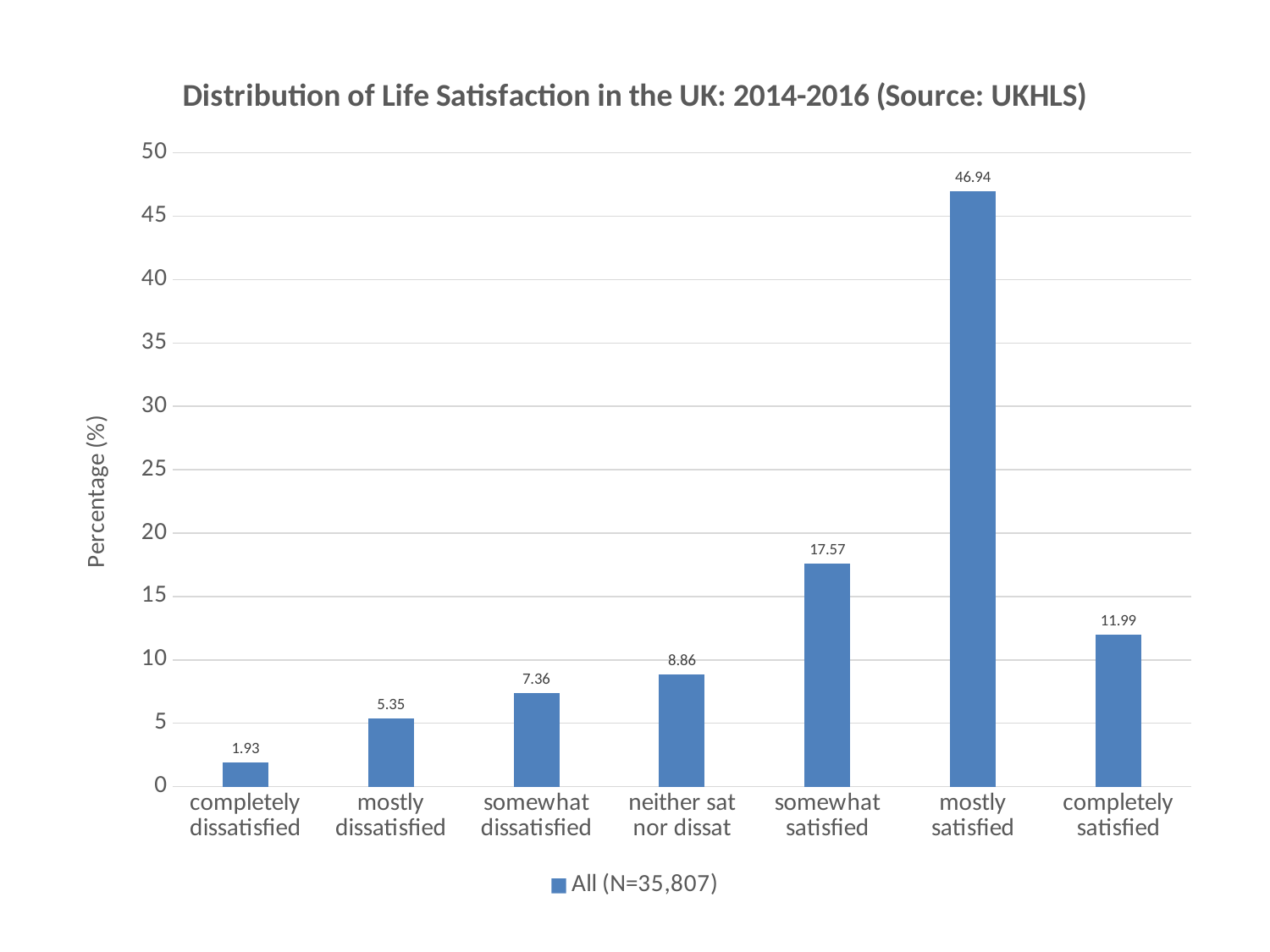
What is the percentage for 'neither sat nor dissat'? 8.86 How many series does the legend list? 1 What is the percentage for 'completely dissatisfied'? 1.93 Which is larger, the percentage for 'mostly dissatisfied' or for 'somewhat dissatisfied'? somewhat dissatisfied Which category has the lowest percentage? completely dissatisfied Which category has the highest percentage? mostly satisfied What kind of chart is shown on the slide? bar chart Is the value for 'somewhat satisfied' greater or less than 15? greater How many categories are shown on the x axis? 7 What is the percentage for 'mostly satisfied'? 46.94 What is the legend entry for the series? All (N=35,807) What is the difference between the percentages for 'somewhat satisfied' and 'completely satisfied'? 5.58